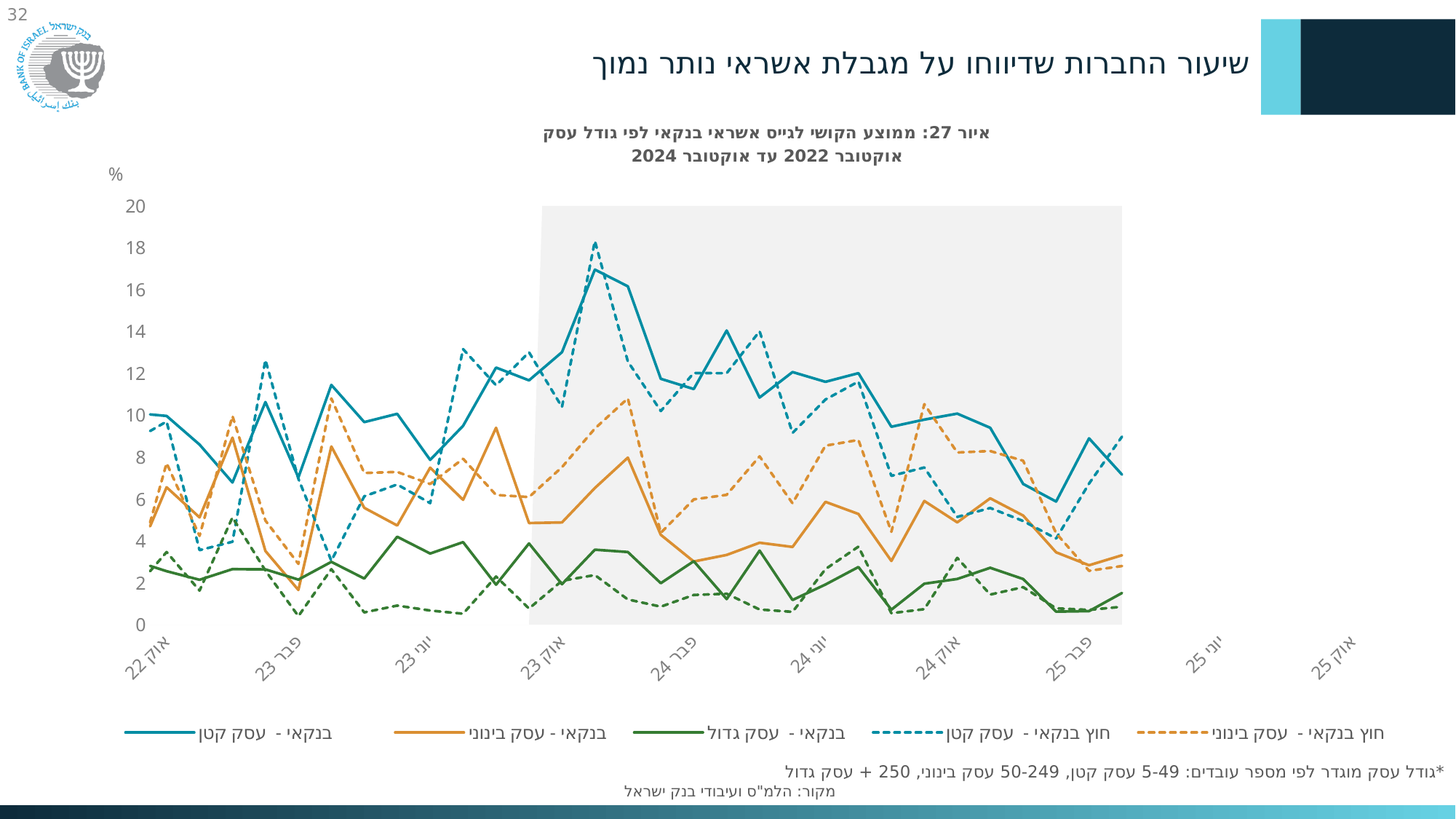
Is the peak value of the dashed line for חוץ בנקאי - עסק קטן greater or less than 16? greater Is the value for בנקאי - עסק קטן at אוק' 22 greater or less than 8? greater What is the title of the chart (איור 27)? איור 27: ממוצע הקושי לגייס אשראי בנקאי לפי גודל עסק אוקטובר 2022 עד אוקטובר 2024 Is the value for בנקאי - עסק גדול at אוק' 22 greater or less than 6? less What unit is shown on the y axis of the chart? % What is the highest value shown on the y axis? 20 Does the line for בנקאי - עסק קטן generally rise or fall between its peak near אוק' 23 and פבר' 25? fall What kind of chart is shown on the slide? line chart At אוק' 22, which is larger: the value for בנקאי - עסק קטן or the value for בנקאי - עסק גדול? בנקאי - עסק קטן How many date labels are shown along the x axis? 10